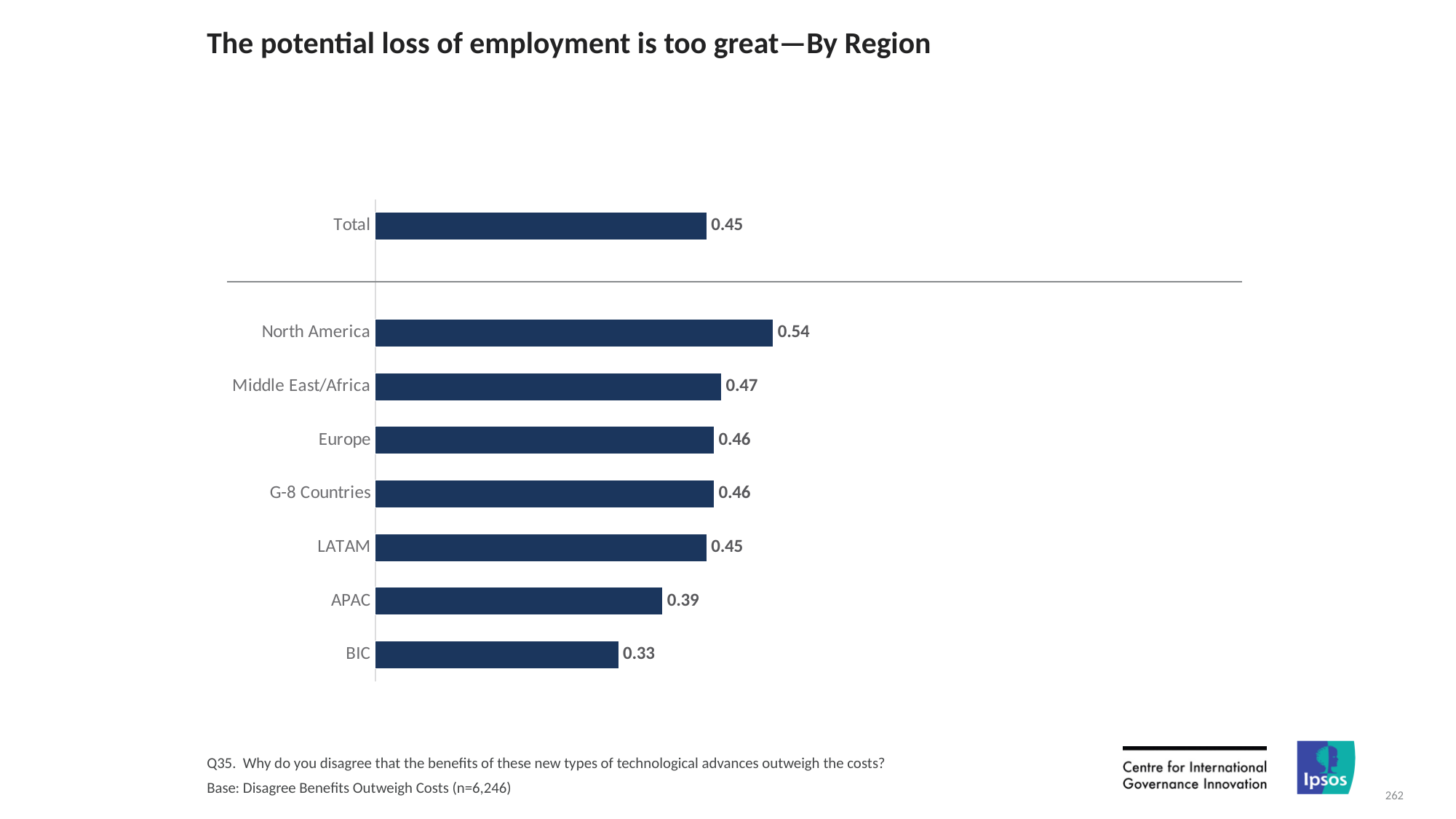
What kind of chart is shown on the slide? Bar chart Which is larger, the value for LATAM or the value for APAC? LATAM What is the value for BIC? 0.33 What is the value for APAC? 0.39 Which region has the highest value? North America What is the value for the Total bar? 0.45 What is the title of the chart? The potential loss of employment is too great—By Region What is the difference between the values for Middle East/Africa and APAC? 0.08 Which region has the lowest value? BIC What is the difference between the values for North America and BIC? 0.21 How many bars are shown on the chart, including Total? 8 What is the value for North America? 0.54